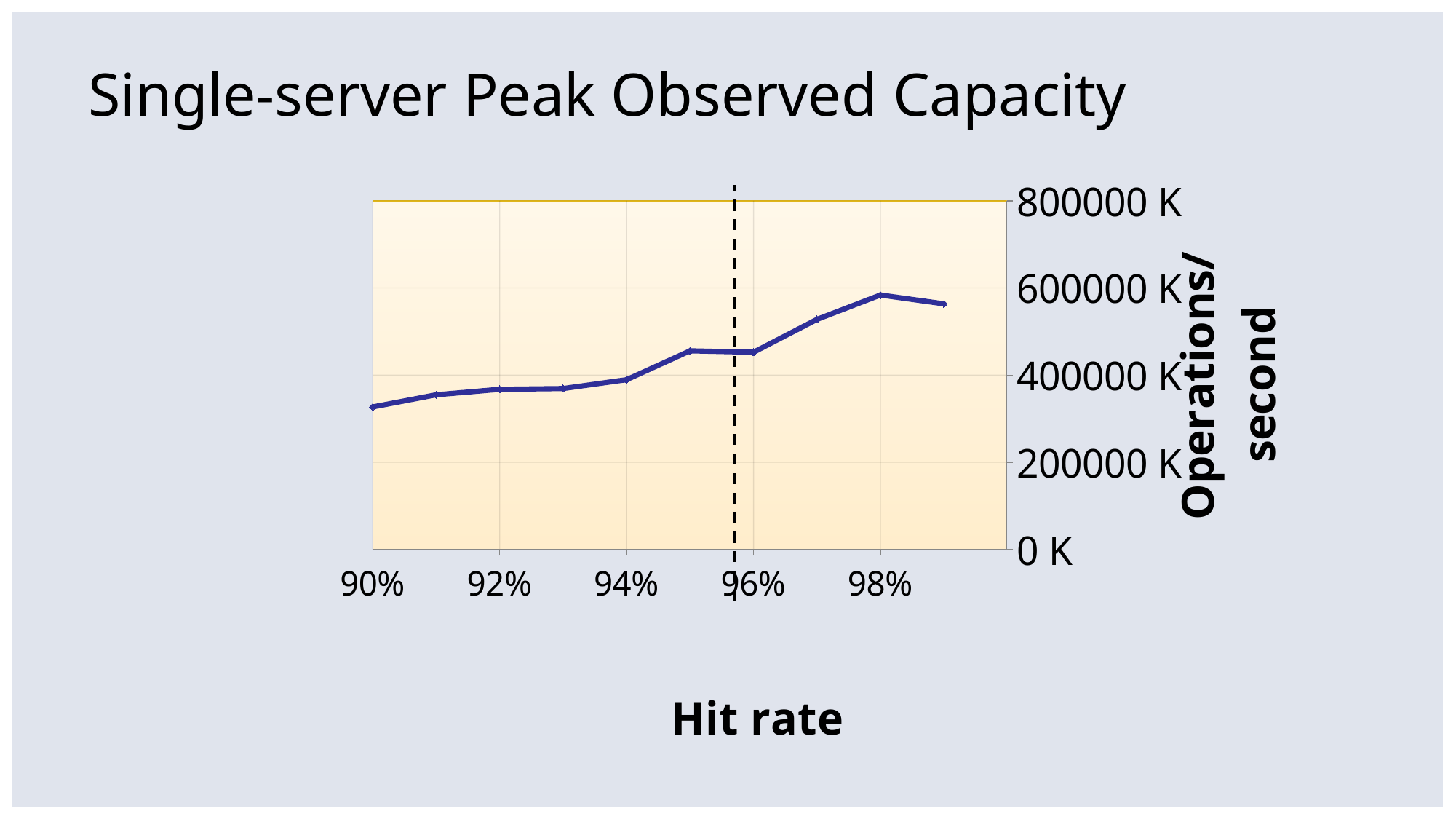
Is the value at a 99% hit rate greater or less than 400000 K? greater Which has the larger value: the 97% hit rate or the 92% hit rate? 97% How many data points are plotted on the line? 10 What is the label of the x axis? Hit rate Is the value at a 92% hit rate greater or less than 400000 K? less At which hit rate is the peak observed capacity highest? 98% Is the value at a 97% hit rate greater or less than 400000 K? greater What kind of chart is shown on the slide? line chart Does the capacity generally rise or fall as the hit rate increases from 90% to 98%? rise At which hit rate is the peak observed capacity lowest? 90% What is the title of the chart? Single-server Peak Observed Capacity